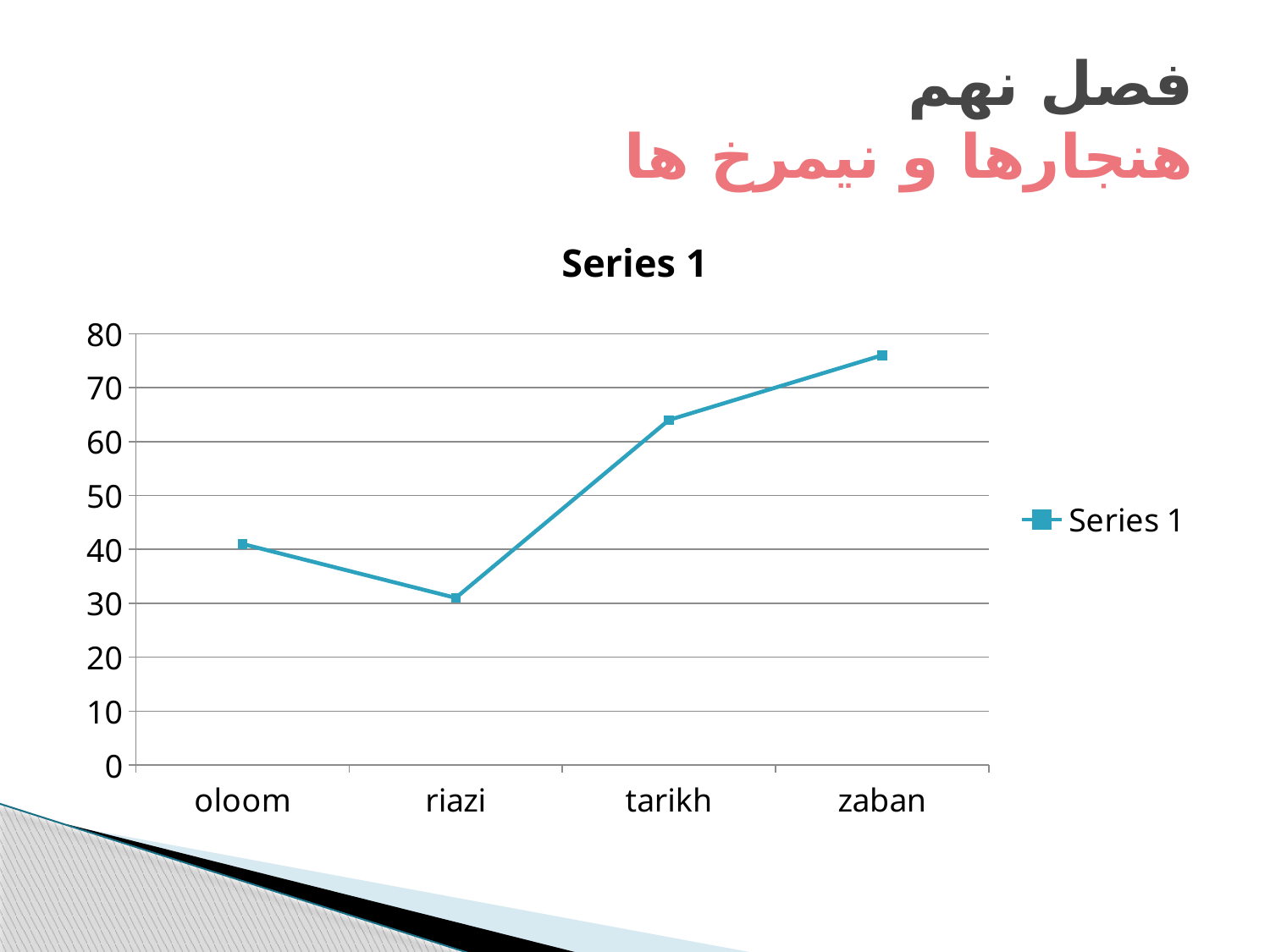
How many series does the legend list? 1 Is the value for tarikh greater or less than 60? greater Is the value for riazi greater or less than 40? less What kind of chart is shown on the slide? line chart Which category has the highest value? zaban Which category has the lowest value? riazi Which has a larger value, oloom or tarikh? tarikh Is the value for zaban greater or less than 80? less What is the title of the chart? Series 1 Does the line rise or fall from riazi to zaban? rise How many categories are shown on the x axis? 4